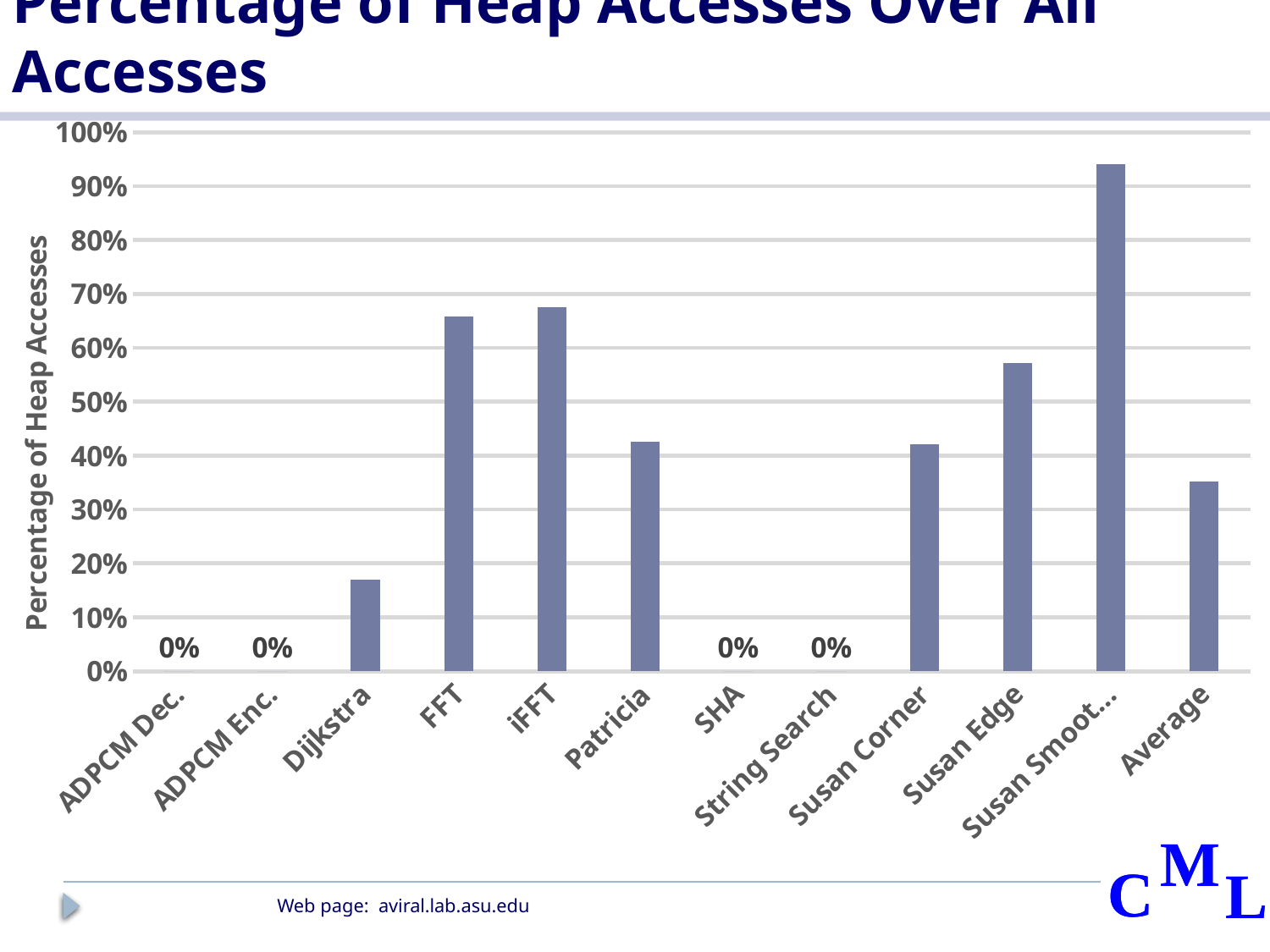
Which is larger, the value for Dijkstra or the value for Average? Average Is the value for Average greater or less than 30%? greater Is the value for FFT greater or less than 60%? greater Is the value for Susan Edge greater or less than 60%? less What kind of chart is shown on the slide? bar chart What is the value for ADPCM Enc.? 0% What is the label on the vertical axis? Percentage of Heap Accesses Which is larger, the value for Susan Edge or the value for Patricia? Susan Edge Which category has the highest percentage of heap accesses? Susan Smoot... What is the value for SHA? 0% How many categories are plotted along the x axis? 12